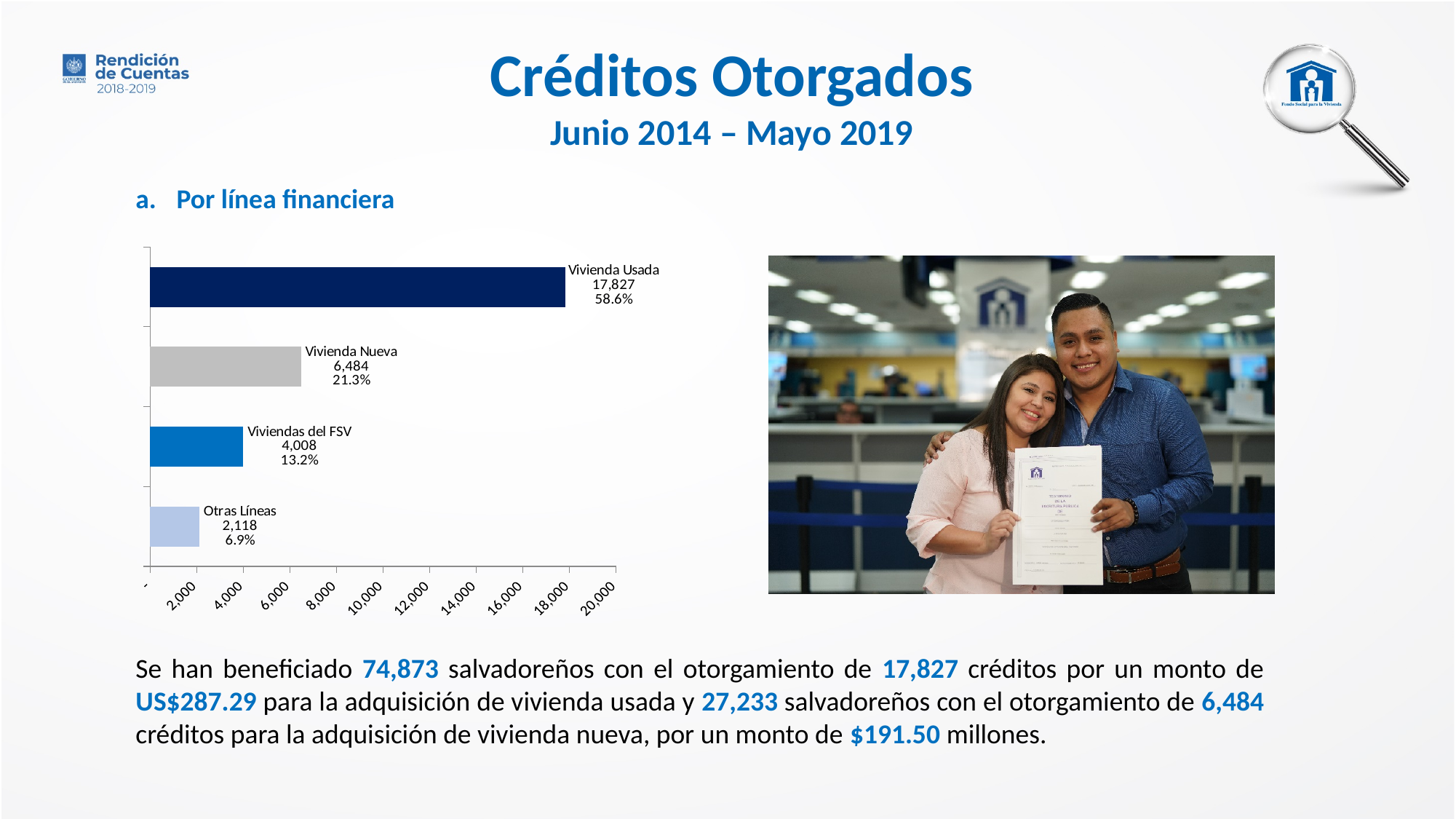
What percentage share is shown for Vivienda Usada? 58.6% What is the value for Otras Líneas? 2,118 What is the difference between the values for Vivienda Usada and Vivienda Nueva? 11,343 Is the value for Vivienda Nueva greater or less than 8,000? less What percentage share is shown for Viviendas del FSV? 13.2% What is the number of credits for Vivienda Nueva? 6,484 Which category has the lowest value? Otras Líneas What is the number of credits for Vivienda Usada? 17,827 Which category has the highest value? Vivienda Usada What kind of chart is shown on the slide? bar chart Which is larger, the value for Viviendas del FSV or Otras Líneas? Viviendas del FSV How many categories are shown in the chart? 4